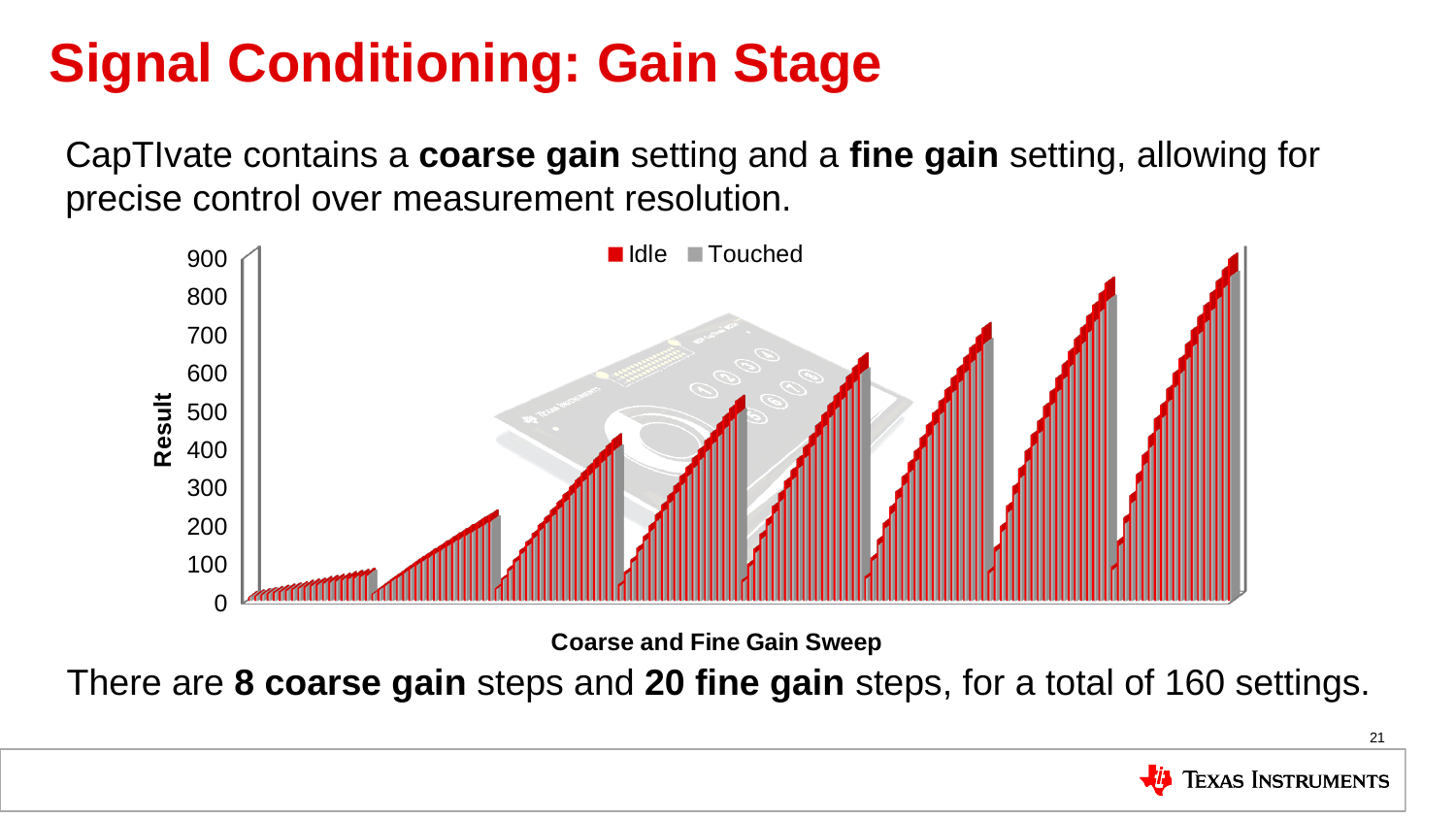
Is the peak value of the fifth ramp greater or less than 600? greater Which series is drawn in red in the chart? Idle What is the title of the chart's horizontal axis? Coarse and Fine Gain Sweep Is the peak value of the first (leftmost) ramp greater or less than 100? less How many series does the chart legend list? 2 Is the peak value of the second ramp greater or less than 200? greater What is the highest tick value shown on the Result axis? 900 What kind of chart is shown on the slide? bar chart Do the peak values of the successive ramps rise or fall from left to right along the x axis? rise How many sawtooth ramps (coarse gain steps) are visible in the chart? 8